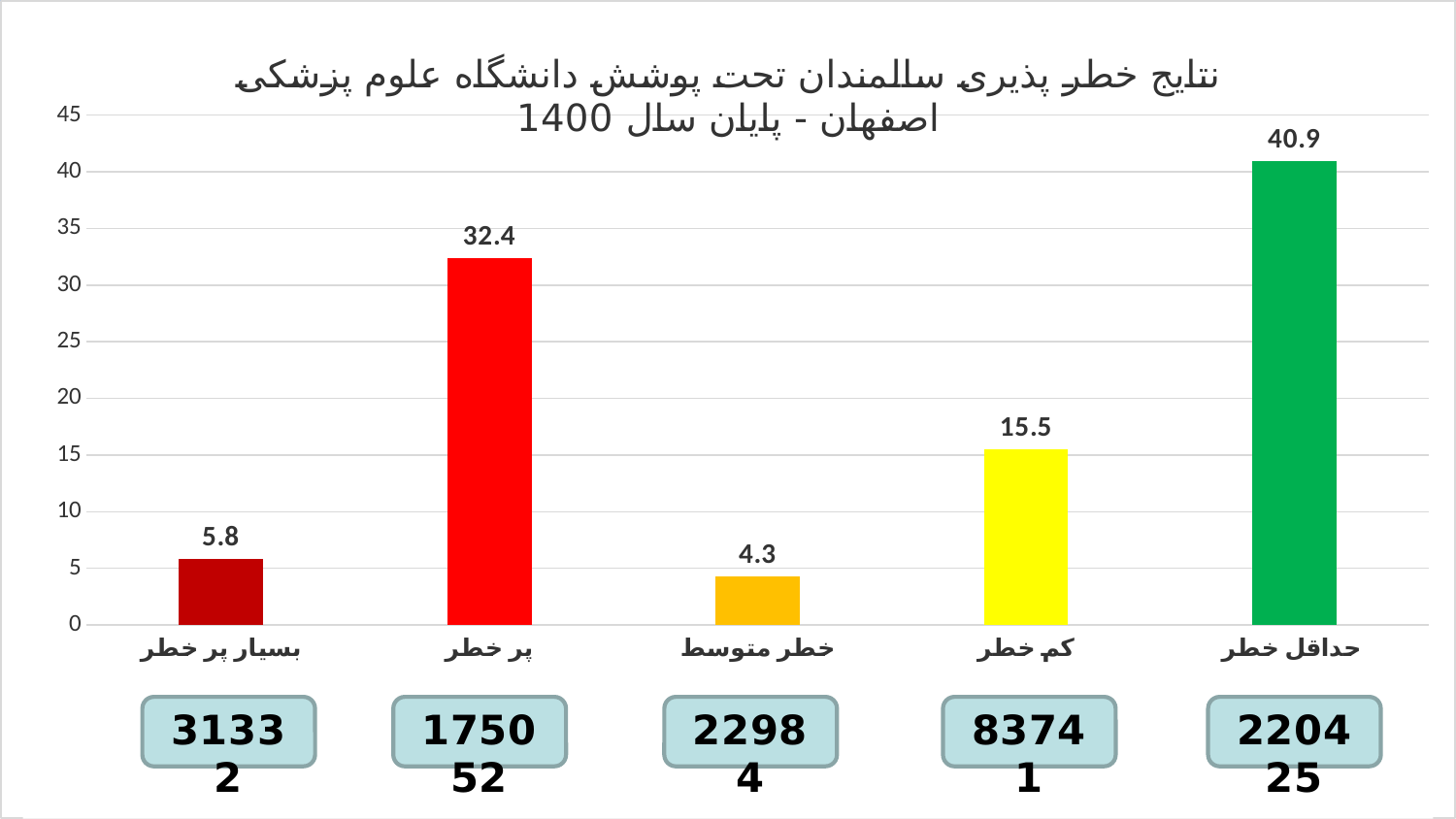
What is the value for the category "حداقل خطر"? 40.9 What is the difference between the values for "بسیار پر خطر" and "خطر متوسط"? 1.5 Which category has the highest value? حداقل خطر Which is larger, the value for "کم خطر" or the value for "بسیار پر خطر"? کم خطر What is the difference between the values for "حداقل خطر" and "پر خطر"? 8.5 What kind of chart is shown on the slide? bar chart Is the value for "پر خطر" greater or less than 30? greater What colour is the bar for "حداقل خطر"? green What is the value for the category "کم خطر"? 15.5 What is the value for the category "پر خطر"? 32.4 How many categories are shown on the x axis? 5 Which category has the lowest value? خطر متوسط